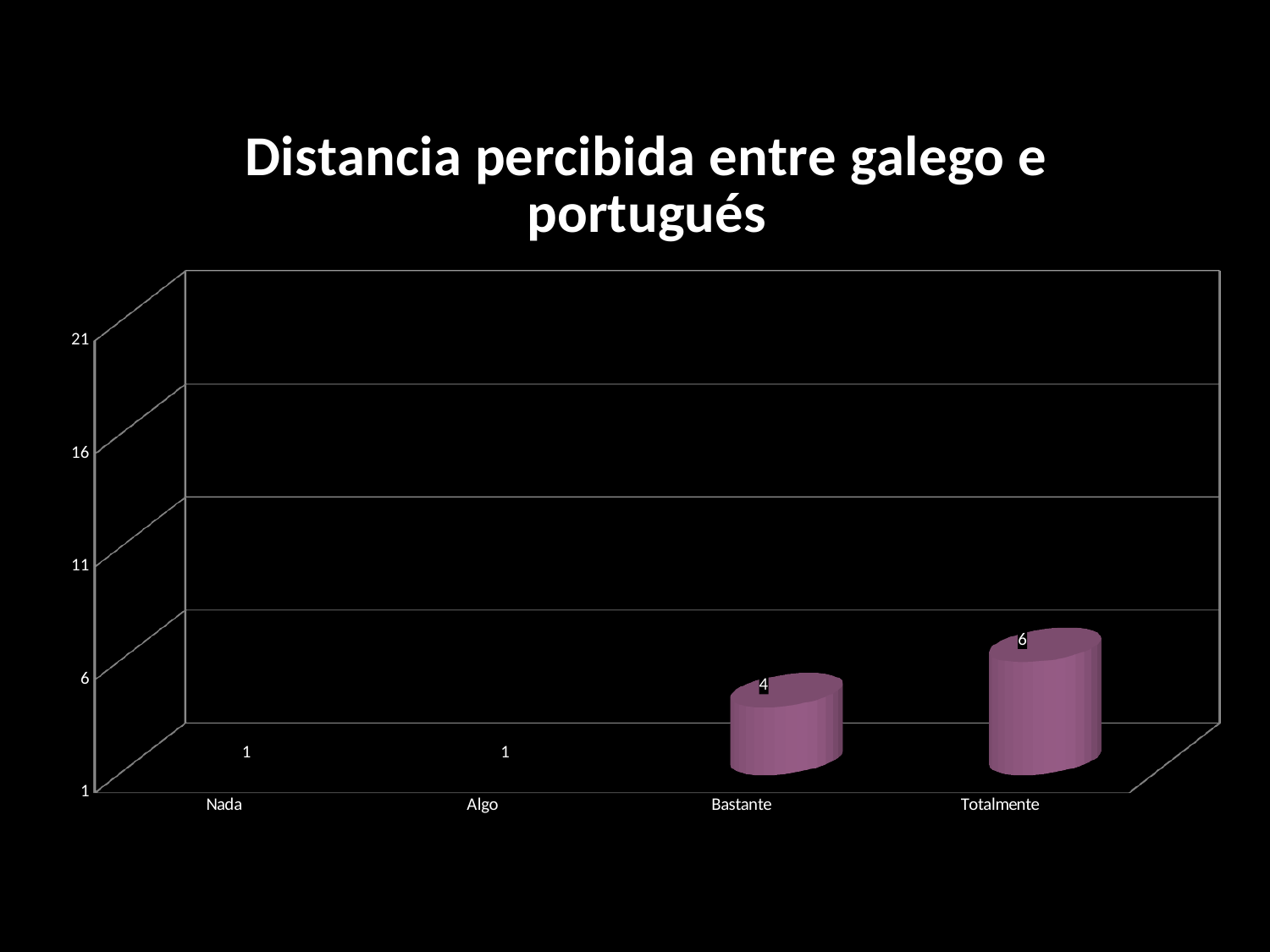
How many categories are shown on the x axis? 4 Which is larger, the value for Bastante or the value for Totalmente? Totalmente What is the title of the chart? Distancia percibida entre galego e portugués What is the value for Algo? 1 What kind of chart is shown on the slide? bar chart What is the difference between the values for Bastante and Algo? 3 Which category has the highest value? Totalmente What is the value for Bastante? 4 Is the value for Totalmente greater or less than 11? less What is the value for Nada? 1 What is the difference between the values for Totalmente and Bastante? 2 What is the value for Totalmente? 6